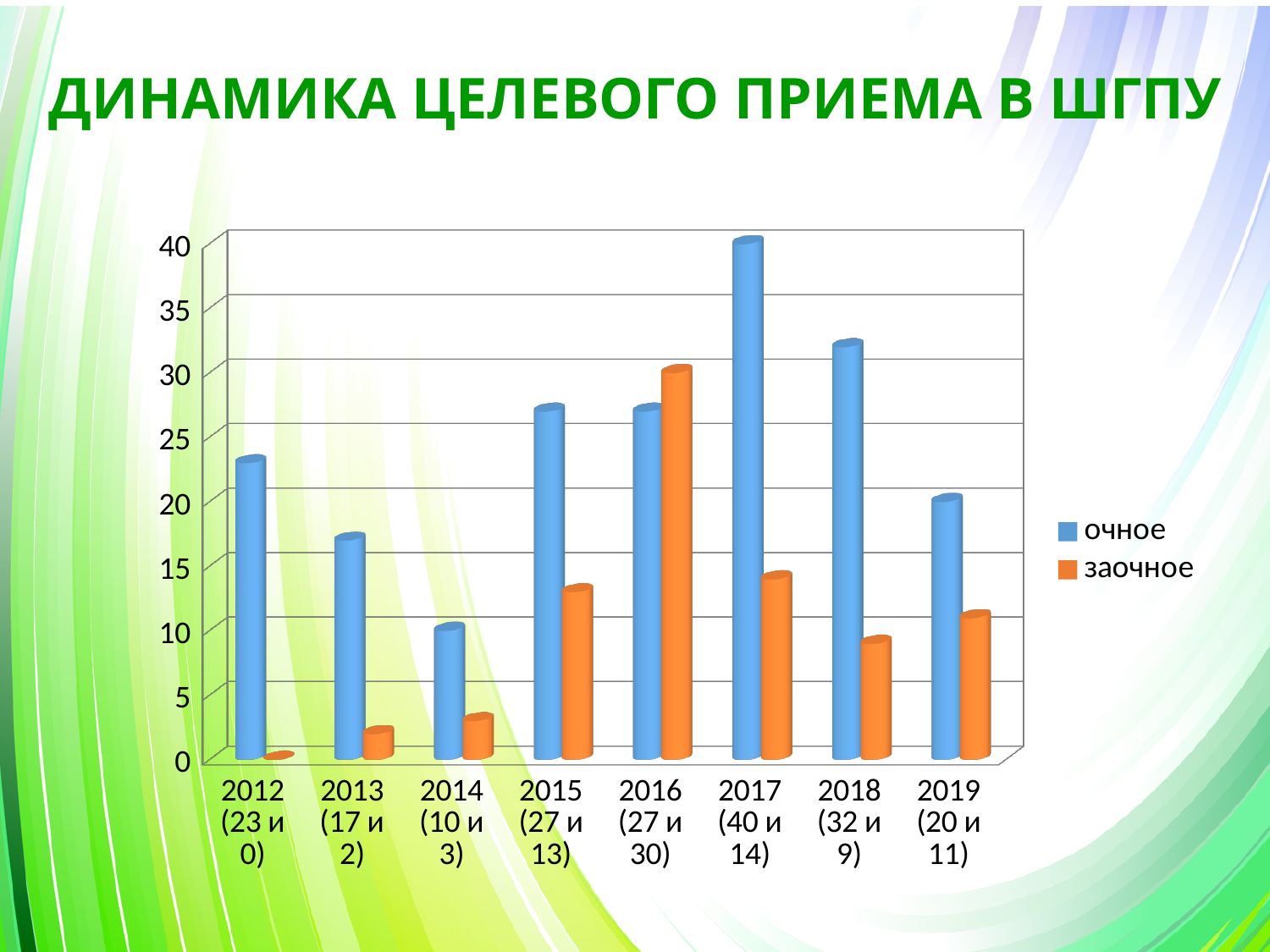
How many years (categories) are shown on the x axis? 8 What is the value for заочное in 2016? 30 Which is larger in 2016, очное or заочное? заочное What is the title of the chart? ДИНАМИКА ЦЕЛЕВОГО ПРИЕМА В ШГПУ Does the value for очное rise or fall from 2017 to 2019? fall What type of chart is shown on the slide? bar chart Which year has the lowest value for заочное? 2012 What is the value for очное in 2017? 40 How many series does the legend list? 2 Which year has the highest value for очное? 2017 What is the difference between очное and заочное in 2018? 23 Is the value for очное in 2015 greater or less than 25? greater